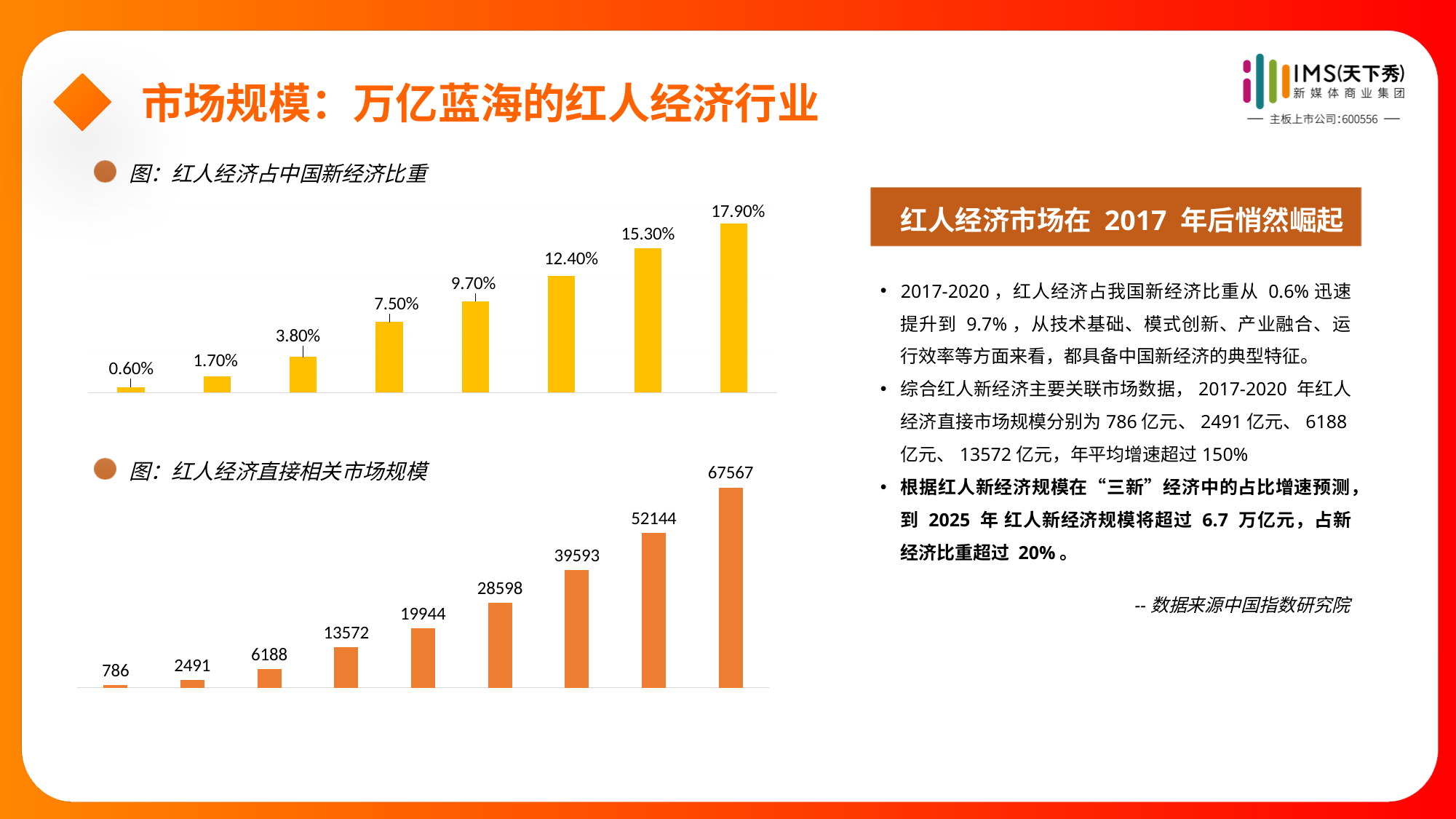
In the bottom chart (红人经济直接相关市场规模), what is the difference between the last bar (67567) and the second-to-last bar (52144)? 15423 In the top chart (红人经济占中国新经济比重), what is the highest value shown? 17.90% In the top chart (红人经济占中国新经济比重), what is the value of the last (rightmost) bar? 17.90% In the top chart (红人经济占中国新经济比重), what is the value of the first (leftmost) bar? 0.60% In the top chart (红人经济占中国新经济比重), do the values rise or fall from left to right? rise How many bars are plotted in the top chart (红人经济占中国新经济比重)? 8 How many bars are plotted in the bottom chart (红人经济直接相关市场规模)? 9 In the bottom chart (红人经济直接相关市场规模), what is the value of the first (leftmost) bar? 786 In the bottom chart (红人经济直接相关市场规模), what is the value of the last (rightmost) bar? 67567 In the bottom chart (红人经济直接相关市场规模), what is the lowest value shown? 786 What type of chart is the top chart titled 图：红人经济占中国新经济比重? bar chart In the top chart (红人经济占中国新经济比重), what is the difference between the fourth bar (7.50%) and the third bar (3.80%)? 3.70%